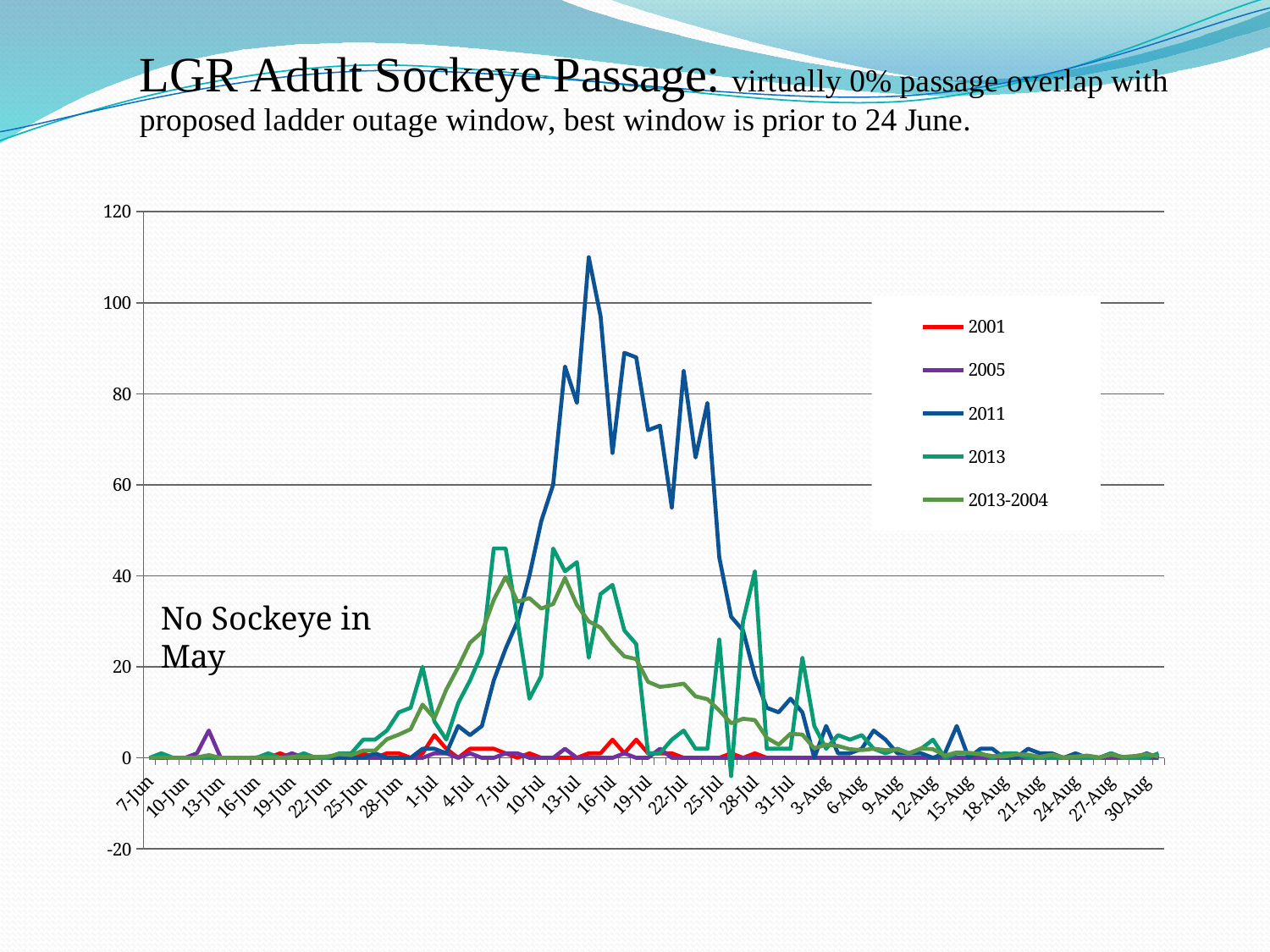
What is the highest value shown on the y axis? 120 Is the highest value of the 2001 series greater or less than 20? less Which series reaches the highest peak on the chart? 2011 How many series does the legend list? 5 Is the highest value of the 2013 series greater or less than 60? less What is the first date label on the x axis? 7-Jun Does the 2011 series rise or fall between 22-Jul and 3-Aug? fall Is the highest value of the 2011 series greater or less than 100? greater What colour is the line for the 2011 series? blue Does the 2011 series rise or fall between 4-Jul and 13-Jul? rise Which series has a higher peak, 2011 or 2013? 2011 What kind of chart is shown on the slide? line chart